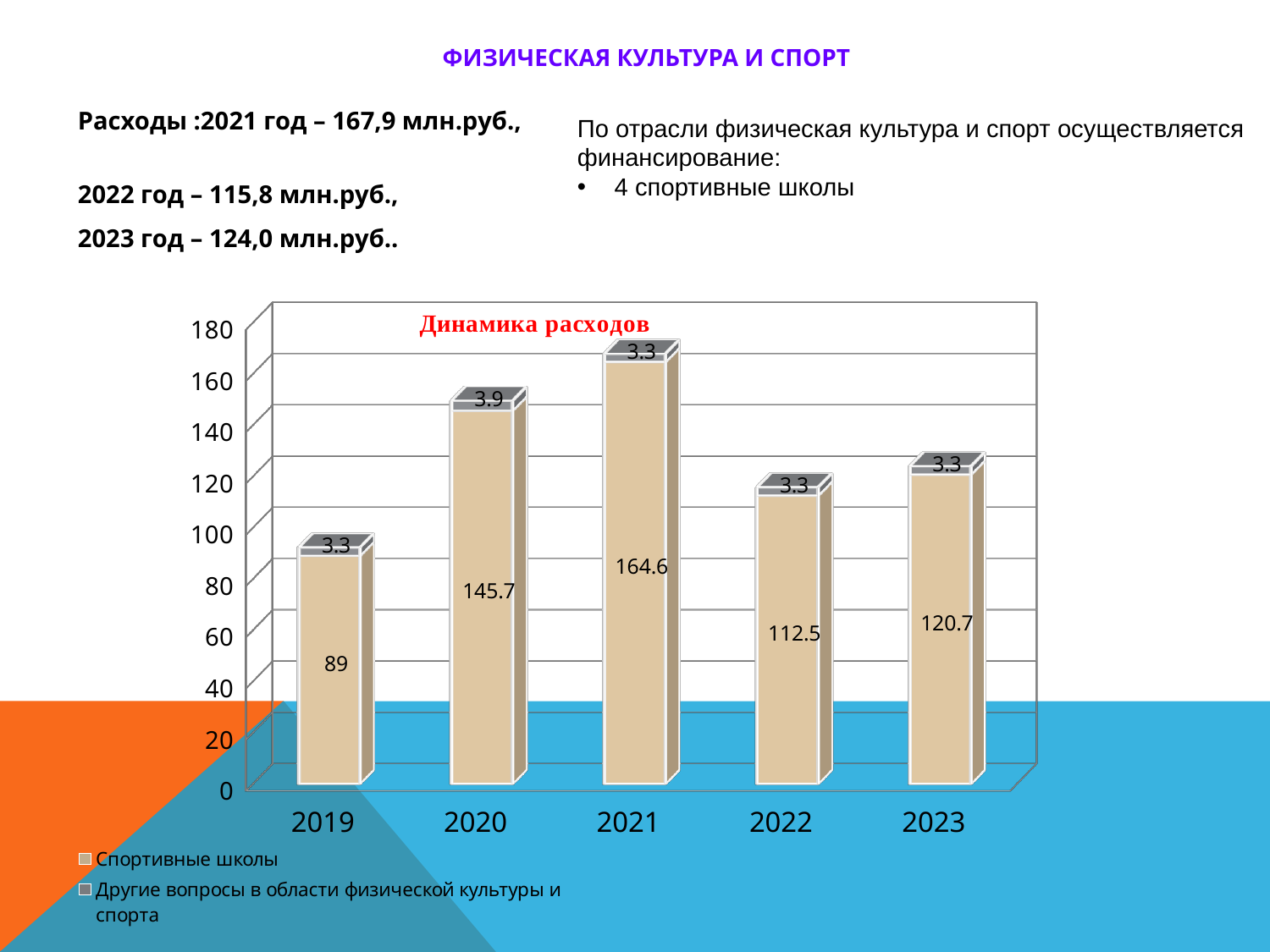
What is the value for Спортивные школы in 2021 on the Динамика расходов chart? 164.6 What is the title of the chart on the slide? Динамика расходов What is the value for Другие вопросы в области физической культуры и спорта in 2020 on the Динамика расходов chart? 3.9 What is the value for Спортивные школы in 2019 on the Динамика расходов chart? 89 How many series does the legend of the Динамика расходов chart list? 2 How many years are shown on the x axis of the Динамика расходов chart? 5 Which is larger on the Динамика расходов chart: the Спортивные школы value for 2020 or for 2023? 2020 Which year has the highest value for Спортивные школы on the Динамика расходов chart? 2021 Which year has the lowest value for Спортивные школы on the Динамика расходов chart? 2019 What is the difference between the Спортивные школы values for 2021 and 2022 on the Динамика расходов chart? 52.1 What is the total of the stacked bar for 2021 on the Динамика расходов chart? 167.9 What kind of chart is the Динамика расходов chart? Stacked bar chart